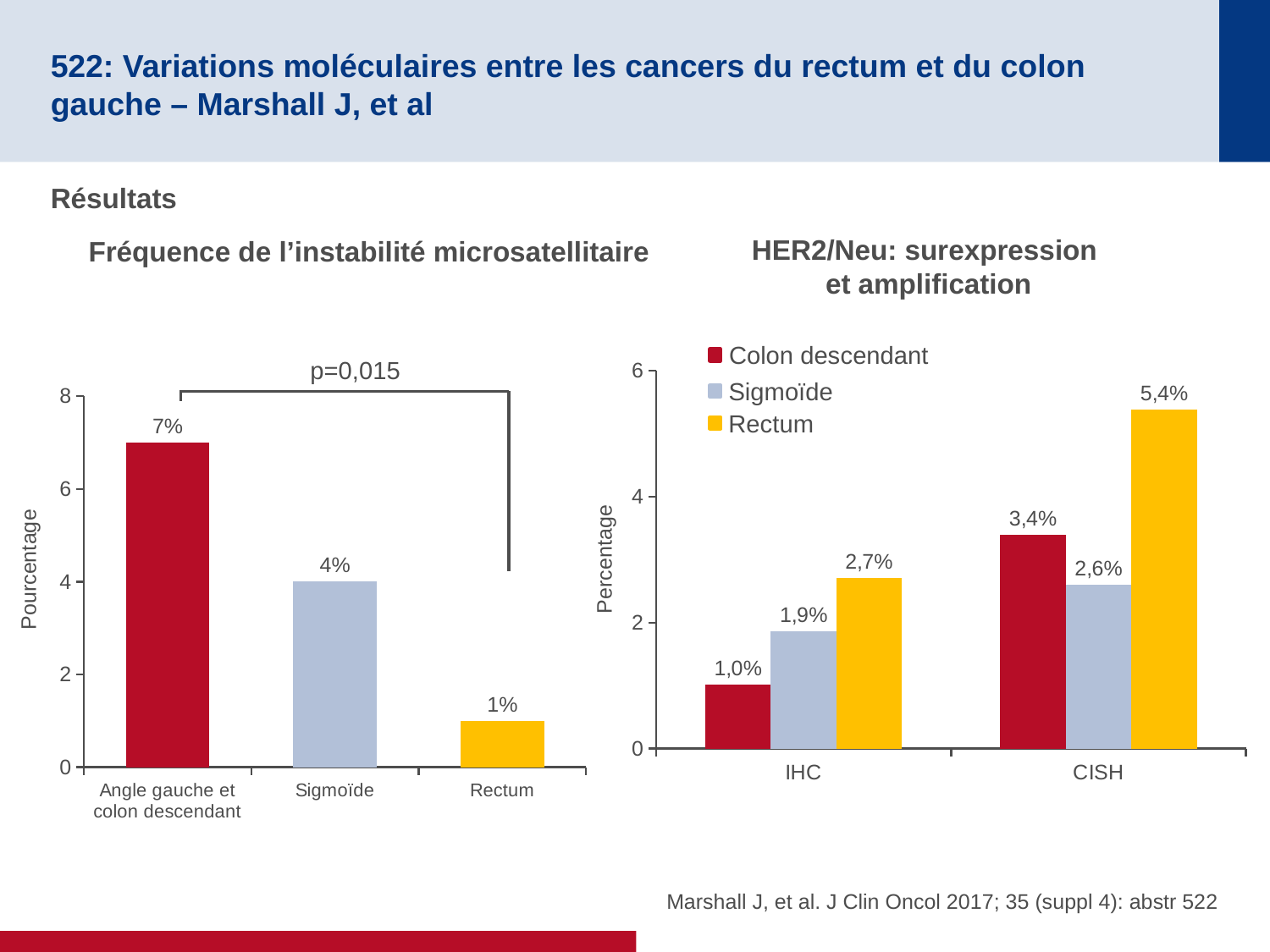
In the 'HER2/Neu: surexpression et amplification' chart, what is the difference between the Rectum values for CISH and IHC? 2,7% In the 'HER2/Neu: surexpression et amplification' chart, which is larger under CISH: Colon descendant or Sigmoïde? Colon descendant In the 'Fréquence de l'instabilité microsatellitaire' chart, what p-value is shown? p=0,015 In the 'HER2/Neu: surexpression et amplification' chart, what is the value for Rectum under CISH? 5,4% In the 'Fréquence de l'instabilité microsatellitaire' chart, how many categories are shown on the x axis? 3 In the 'Fréquence de l'instabilité microsatellitaire' chart, which category has the highest value? Angle gauche et colon descendant In the 'Fréquence de l'instabilité microsatellitaire' chart, which category has the lowest value? Rectum In the 'HER2/Neu: surexpression et amplification' chart, what is the value for Colon descendant under IHC? 1,0% What kind of chart is the 'HER2/Neu: surexpression et amplification' chart? Bar chart In the 'Fréquence de l'instabilité microsatellitaire' chart, what is the difference between the values for Angle gauche et colon descendant and Rectum? 6% In the 'Fréquence de l'instabilité microsatellitaire' chart, what is the value for Sigmoïde? 4% In the 'HER2/Neu: surexpression et amplification' chart, how many series does the legend list? 3